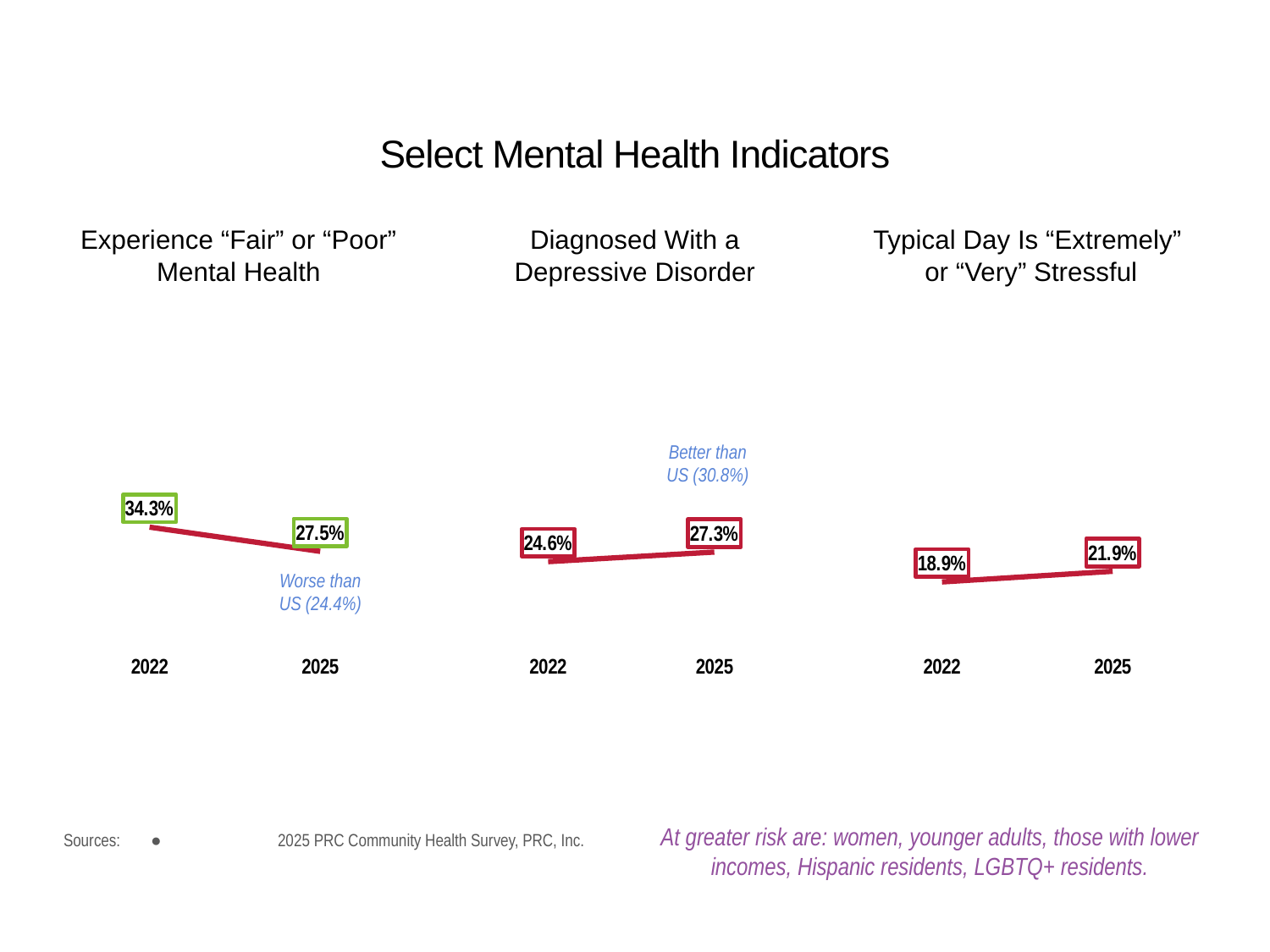
In the "Diagnosed With a Depressive Disorder" chart, what is the value for 2022? 24.6% How many data points are plotted in the "Typical Day Is "Extremely" or "Very" Stressful" chart? 2 In the "Experience "Fair" or "Poor" Mental Health" chart, does the value rise or fall from 2022 to 2025? fall In the "Experience "Fair" or "Poor" Mental Health" chart, what is the difference between the 2022 and 2025 values? 6.8% In the "Typical Day Is "Extremely" or "Very" Stressful" chart, what is the value for 2025? 21.9% In the "Typical Day Is "Extremely" or "Very" Stressful" chart, what is the value for 2022? 18.9% In the "Diagnosed With a Depressive Disorder" chart, what is the value for 2025? 27.3% In the "Diagnosed With a Depressive Disorder" chart, does the value rise or fall from 2022 to 2025? rise In the "Experience "Fair" or "Poor" Mental Health" chart, what is the value for 2022? 34.3% In the "Typical Day Is "Extremely" or "Very" Stressful" chart, what is the difference between the 2025 and 2022 values? 3.0% What kind of chart is used for the "Diagnosed With a Depressive Disorder" indicator? line chart In the "Experience "Fair" or "Poor" Mental Health" chart, what is the value for 2025? 27.5%